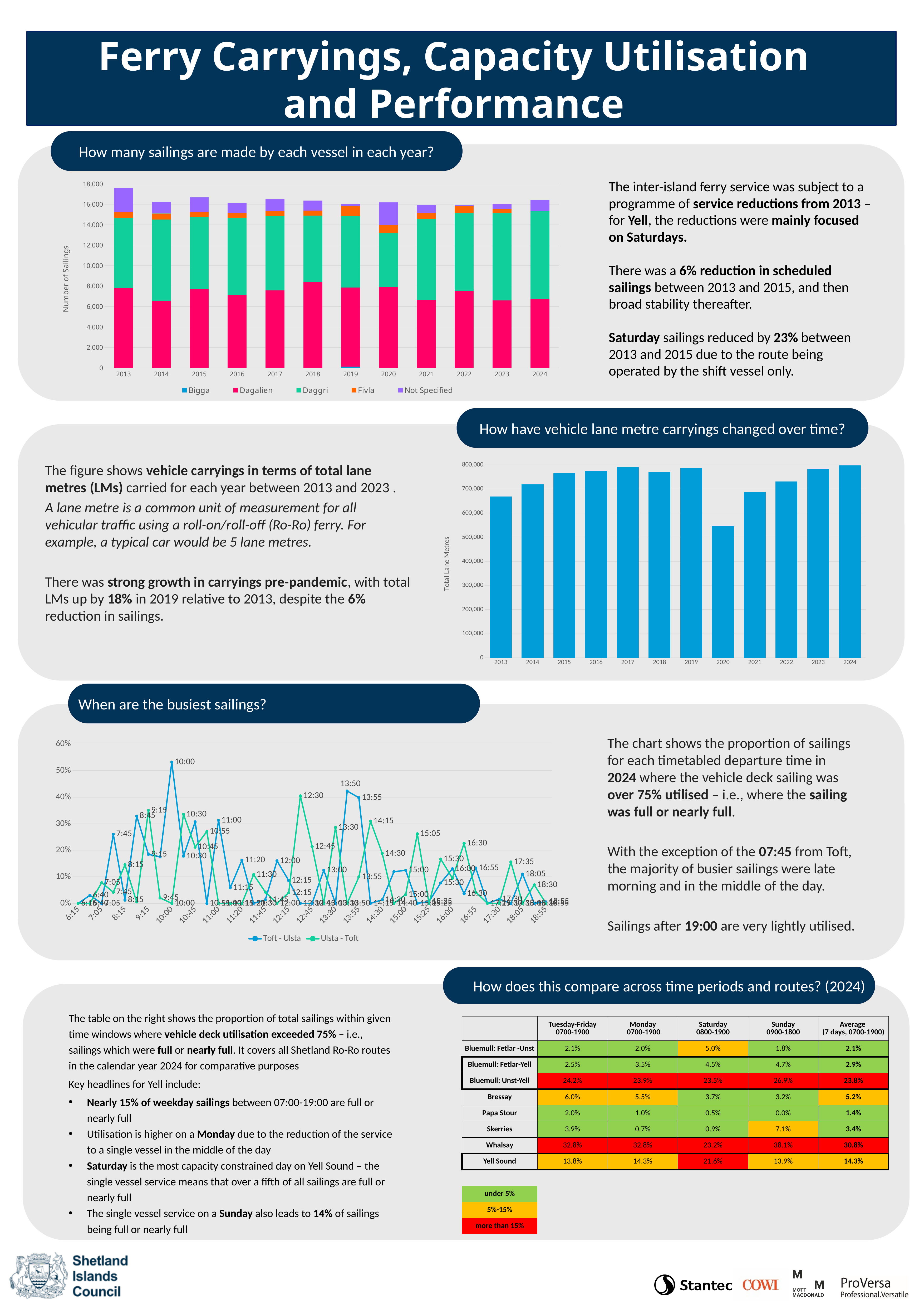
In the sailings-by-vessel chart, is the total number of sailings in 2013 greater or less than 16,000? greater In the 'How have vehicle lane metre carryings changed over time?' chart, which year has the lowest total lane metres? 2020 In the vehicle lane metre chart, which is larger: the value for 2013 or the value for 2019? 2019 In the vehicle lane metre chart, do the values rise or fall from 2013 to 2017? rise In the sailings-by-vessel chart, is the Dagalien value for 2014 greater or less than 8,000? less What kind of chart is the 'How many sailings are made by each vessel in each year?' chart? Stacked bar chart How many years are shown on the x axis of the sailings-by-vessel chart? 12 In the 'When are the busiest sailings?' chart, how many series does the legend list? 2 In the vehicle lane metre chart, is the value for 2013 greater or less than 700,000? less How many series does the legend of the sailings-by-vessel chart list? 5 In the sailings-by-vessel chart, which vessel is shown in pink at the bottom of each bar? Dagalien